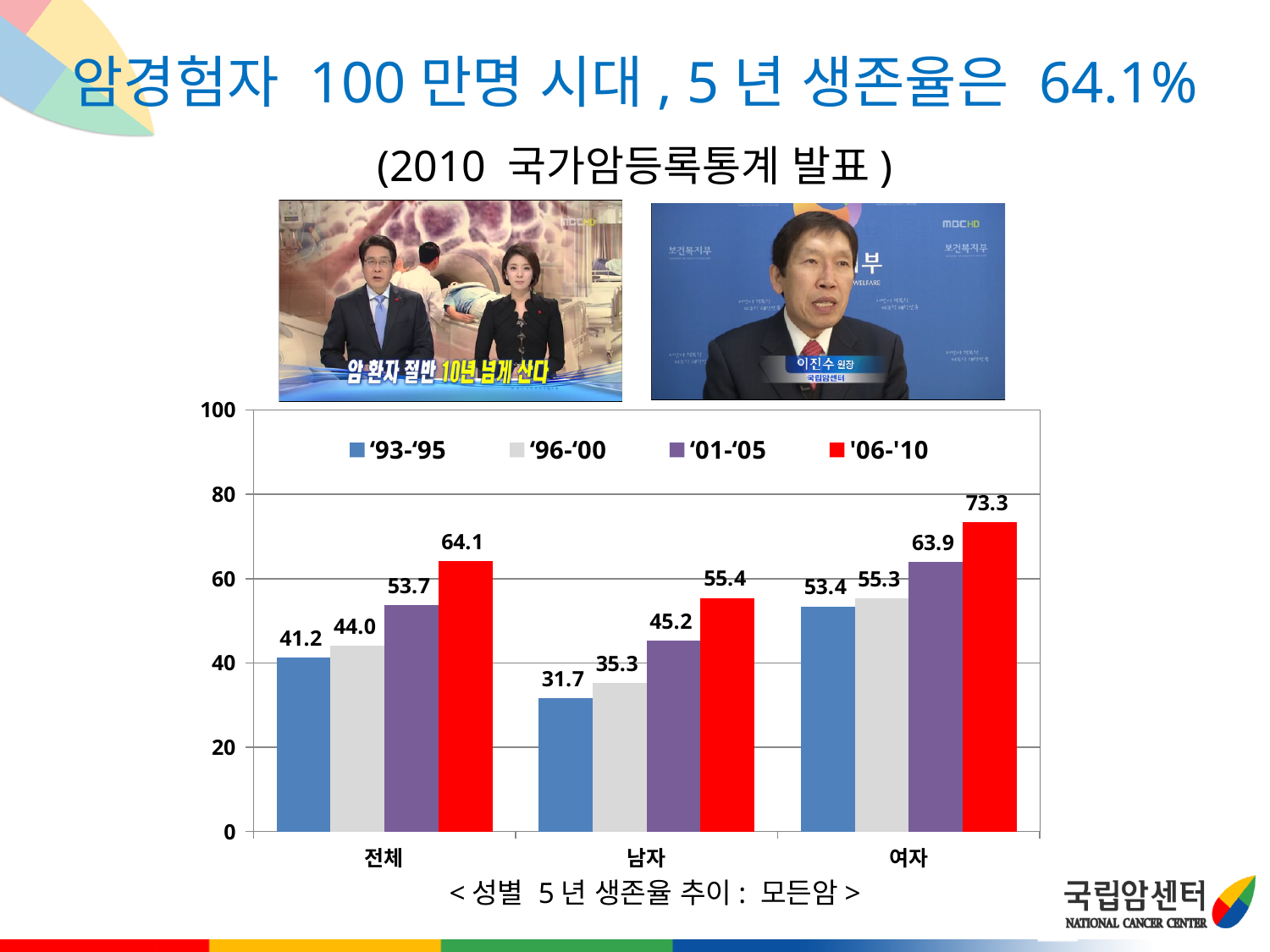
Is the '06-'10 value for 남자 greater or less than 60? less What is the difference between the '06-'10 and '93-'95 values for 여자? 19.9 How many categories are shown on the x axis? 3 What kind of chart is shown on the slide? bar chart Which is larger: the '01-'05 value for 전체 or the '06-'10 value for 남자? '06-'10 value for 남자 How many series does the legend list? 4 What is the value for 여자 in the '01-'05 series? 63.9 What is the value for 남자 in the '93-'95 series? 31.7 Which colour represents the '06-'10 series in the legend? red Which category has the lowest value in the '96-'00 series? 남자 What is the value for 전체 in the '06-'10 series? 64.1 Which category has the highest value in the '06-'10 series? 여자